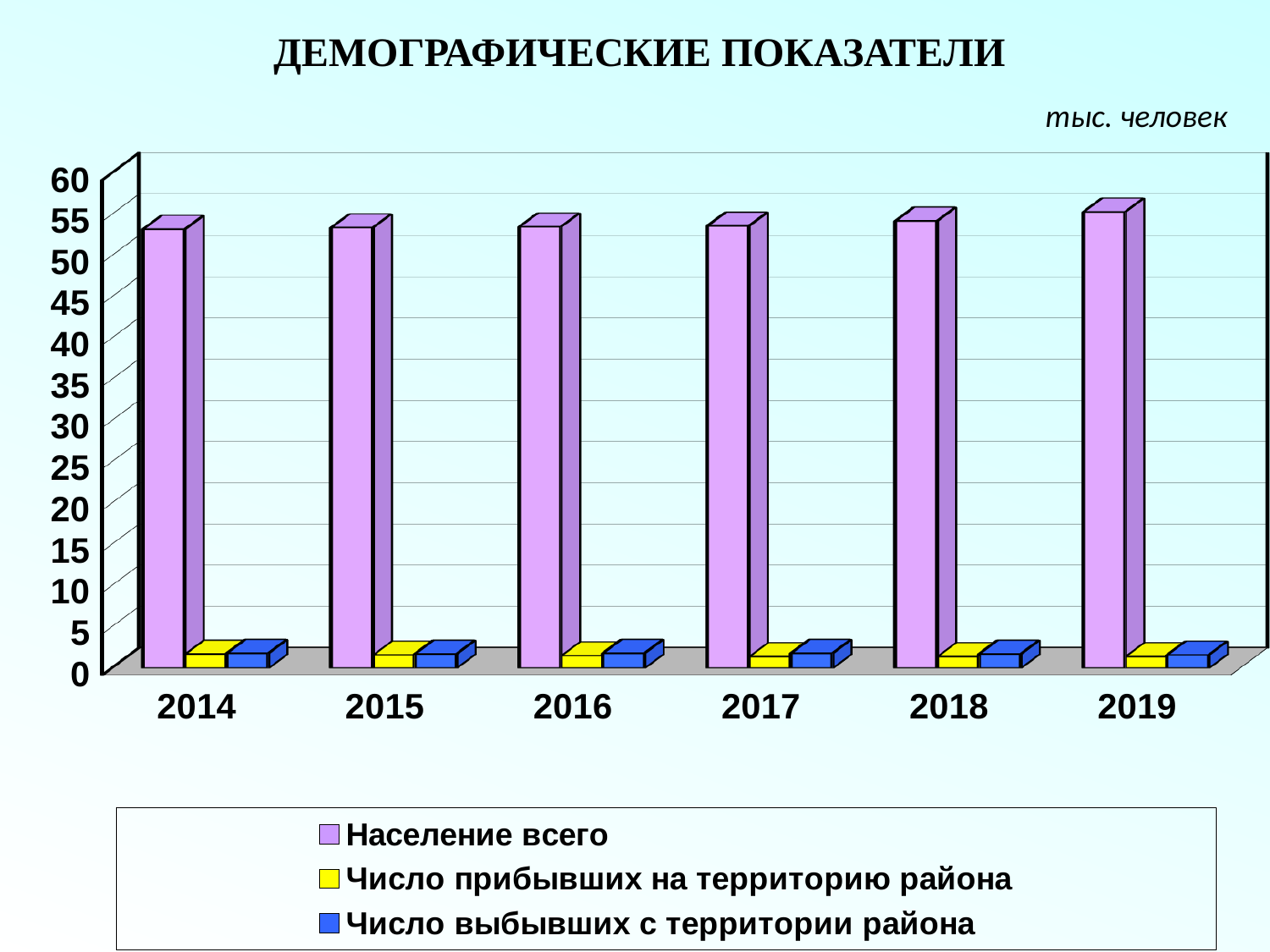
Is the value for Население всего in 2019 greater or less than 60? less Is the value for Население всего in 2014 greater or less than 50? greater In 2017, which is larger: Население всего or Число прибывших на территорию района? Население всего Which series has the highest values in every year shown? Население всего How many years are shown on the x axis of the chart? 6 How many series does the legend list? 3 Is the value for Число выбывших с территории района in 2018 greater or less than 10? less What unit is indicated for the values in the chart? тыс. человек What kind of chart is shown on the slide? bar chart What is the title of the chart? ДЕМОГРАФИЧЕСКИЕ ПОКАЗАТЕЛИ